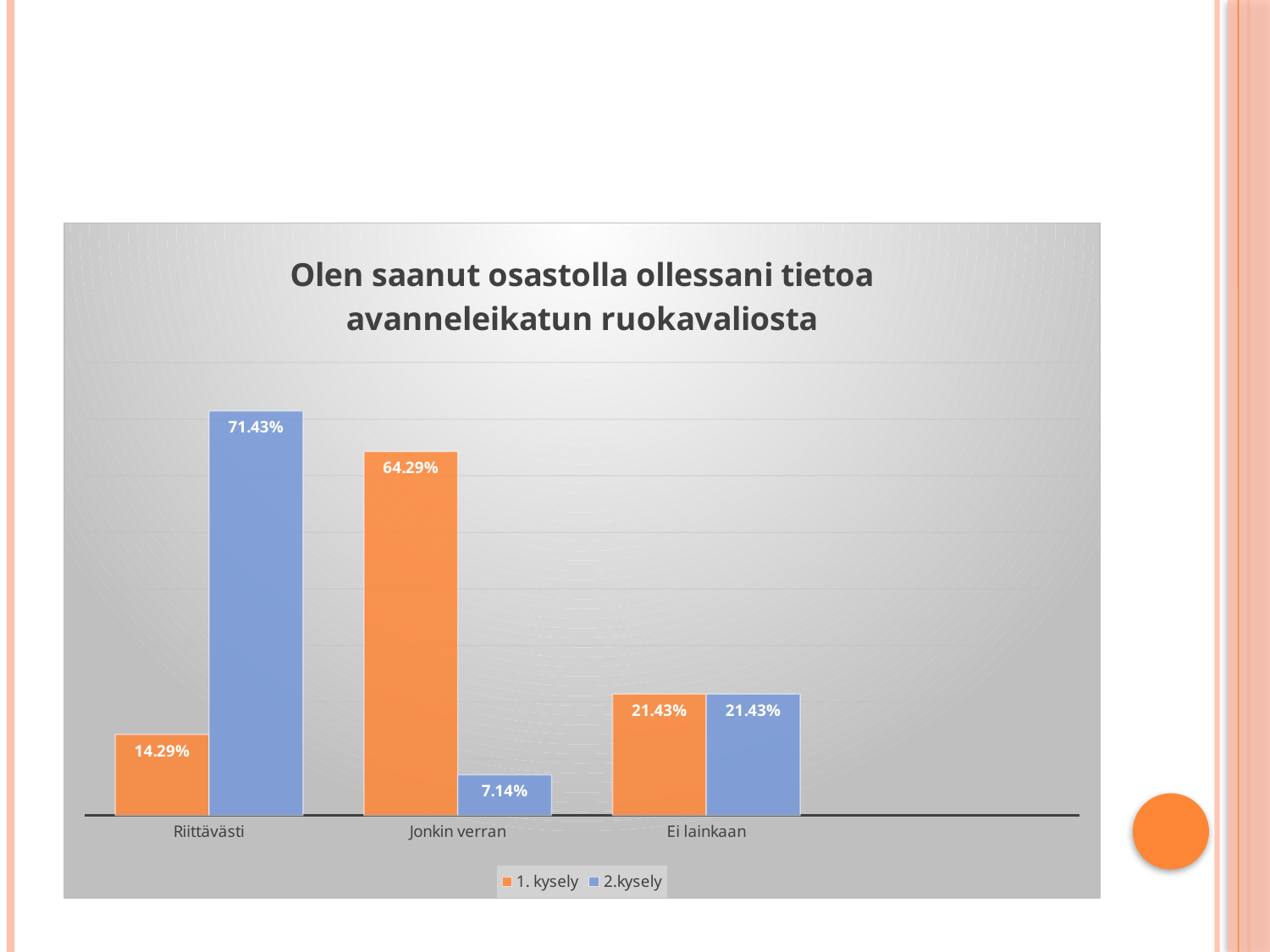
What is the value for Jonkin verran in the 1. kysely series? 64.29% Which category has the lowest value in the 1. kysely series? Riittävästi What kind of chart is shown on the slide? Bar chart Which category has the highest value in the 2.kysely series? Riittävästi How many series does the legend list? 2 What is the value for Ei lainkaan in the 2.kysely series? 21.43% What is the difference between the 2.kysely and 1. kysely values for Riittävästi? 57.14% What is the value for Riittävästi in the 2.kysely series? 71.43% How many categories are shown on the x axis? 3 Which is larger for Jonkin verran: the 1. kysely value or the 2.kysely value? 1. kysely What is the value for Riittävästi in the 1. kysely series? 14.29% What is the value for Jonkin verran in the 2.kysely series? 7.14%